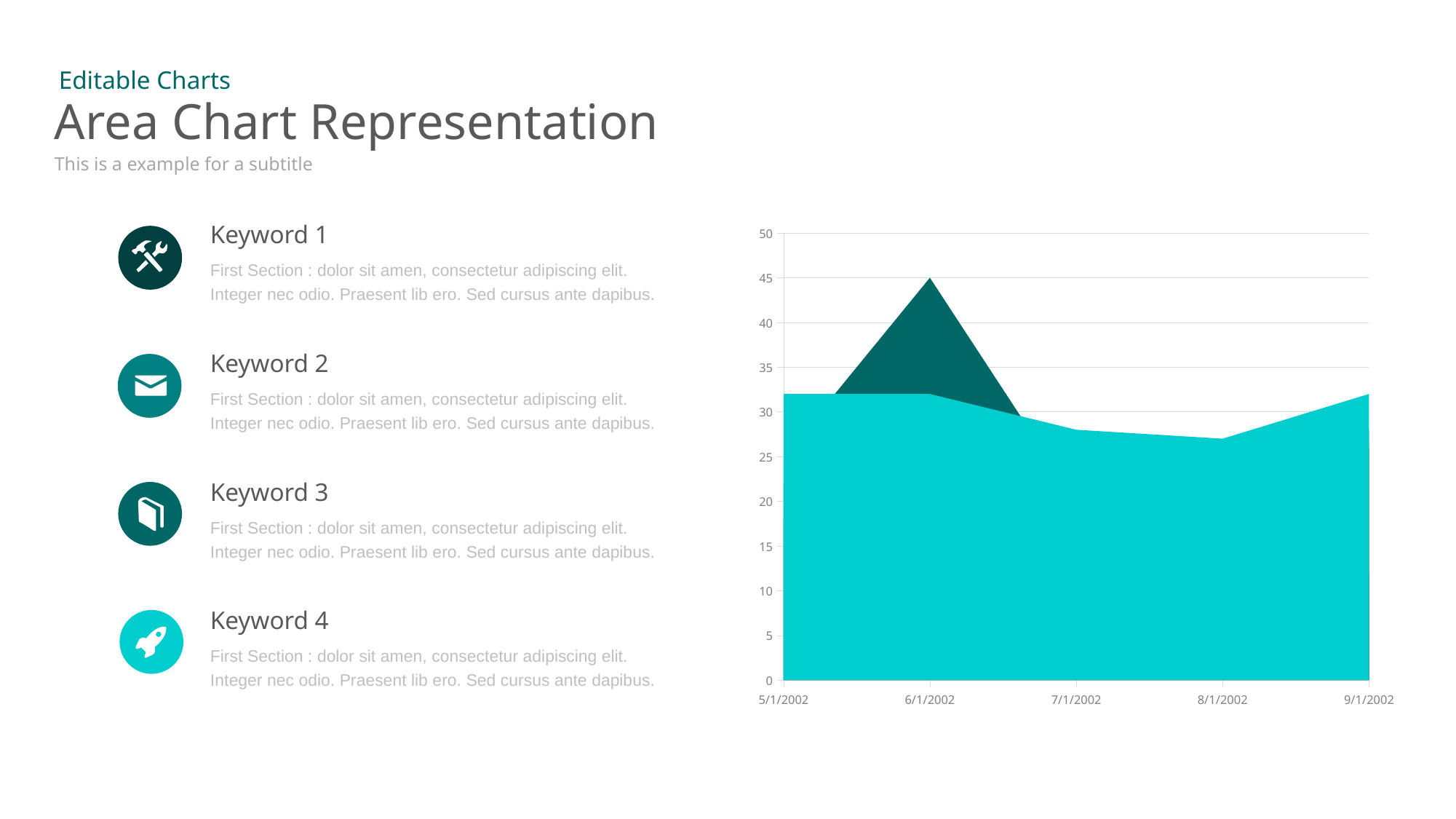
What kind of chart is shown on the slide? Area chart How many dates are labelled on the x axis of the chart? 5 What is the first date labelled on the x axis of the chart? 5/1/2002 Does the light teal area rise or fall between 6/1/2002 and 8/1/2002? fall Is the value of the light teal area at 5/1/2002 greater or less than 30? greater Is the value of the light teal area at 7/1/2002 greater or less than 30? less Is the value of the light teal area at 5/1/2002 larger or smaller than its value at 8/1/2002? larger Is the value of the light teal area at 9/1/2002 greater or less than 25? greater What is the highest value shown on the y axis of the chart? 50 At which date does the dark teal area reach its peak? 6/1/2002 What is the peak value reached by the dark teal area in the chart? 45